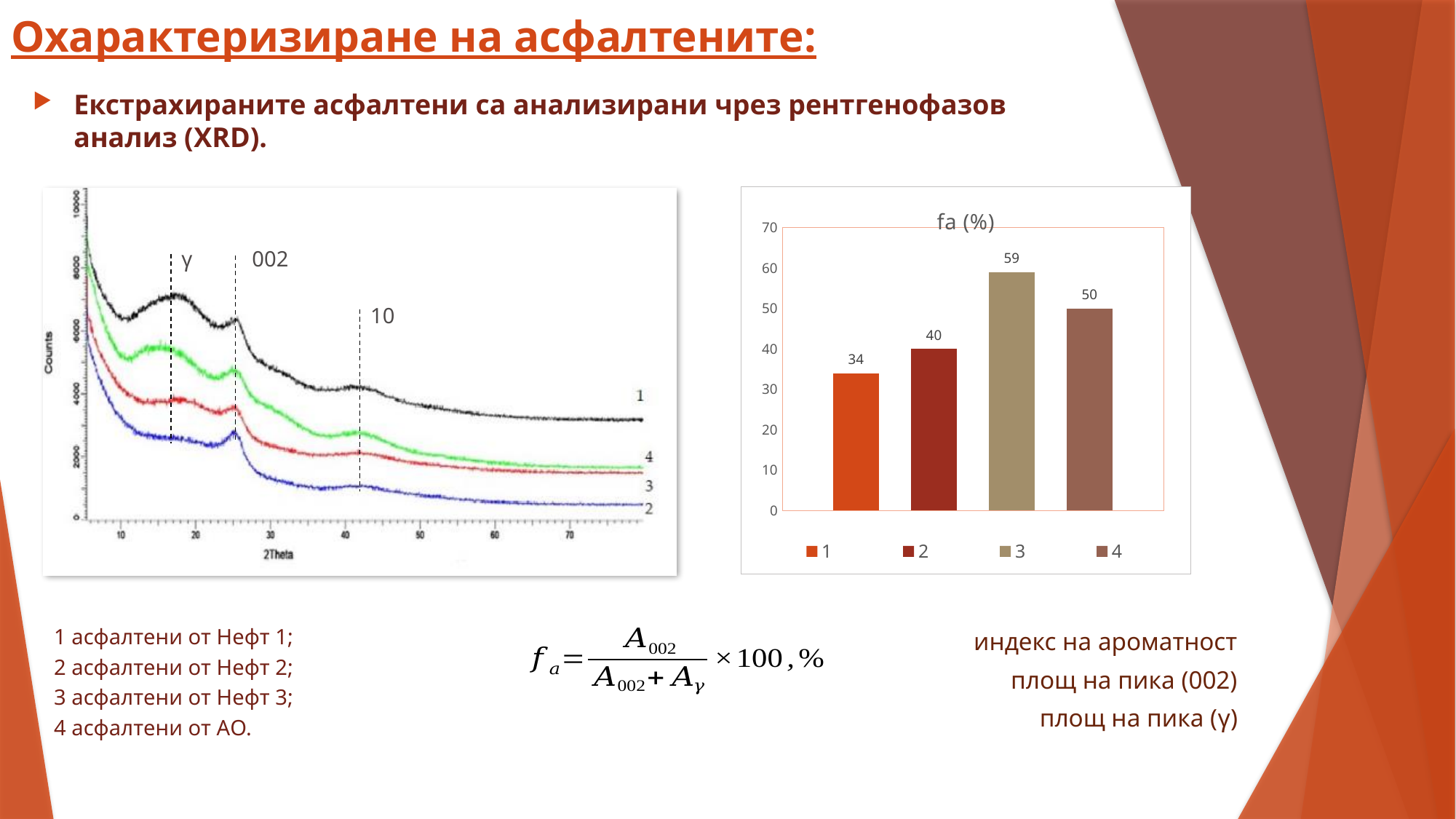
In the fa (%) chart, which is larger, the value for series 2 or series 4? 4 In the fa (%) chart, what is the value for series 1? 34 In the fa (%) chart, which series has the highest value? 3 In the fa (%) chart, which series has the lowest value? 1 What is the x-axis label of the XRD chart on the left of the slide? 2Theta In the fa (%) chart, what is the value for series 3? 59 In the fa (%) chart, is the value for series 2 greater or less than 30? greater How many entries does the legend of the fa (%) chart list? 4 In the fa (%) chart, what is the difference between the values for series 3 and series 2? 19 How many bars are plotted in the fa (%) chart? 4 What kind of chart is the fa (%) chart on the right of the slide? bar chart In the fa (%) chart, what is the value for series 4? 50